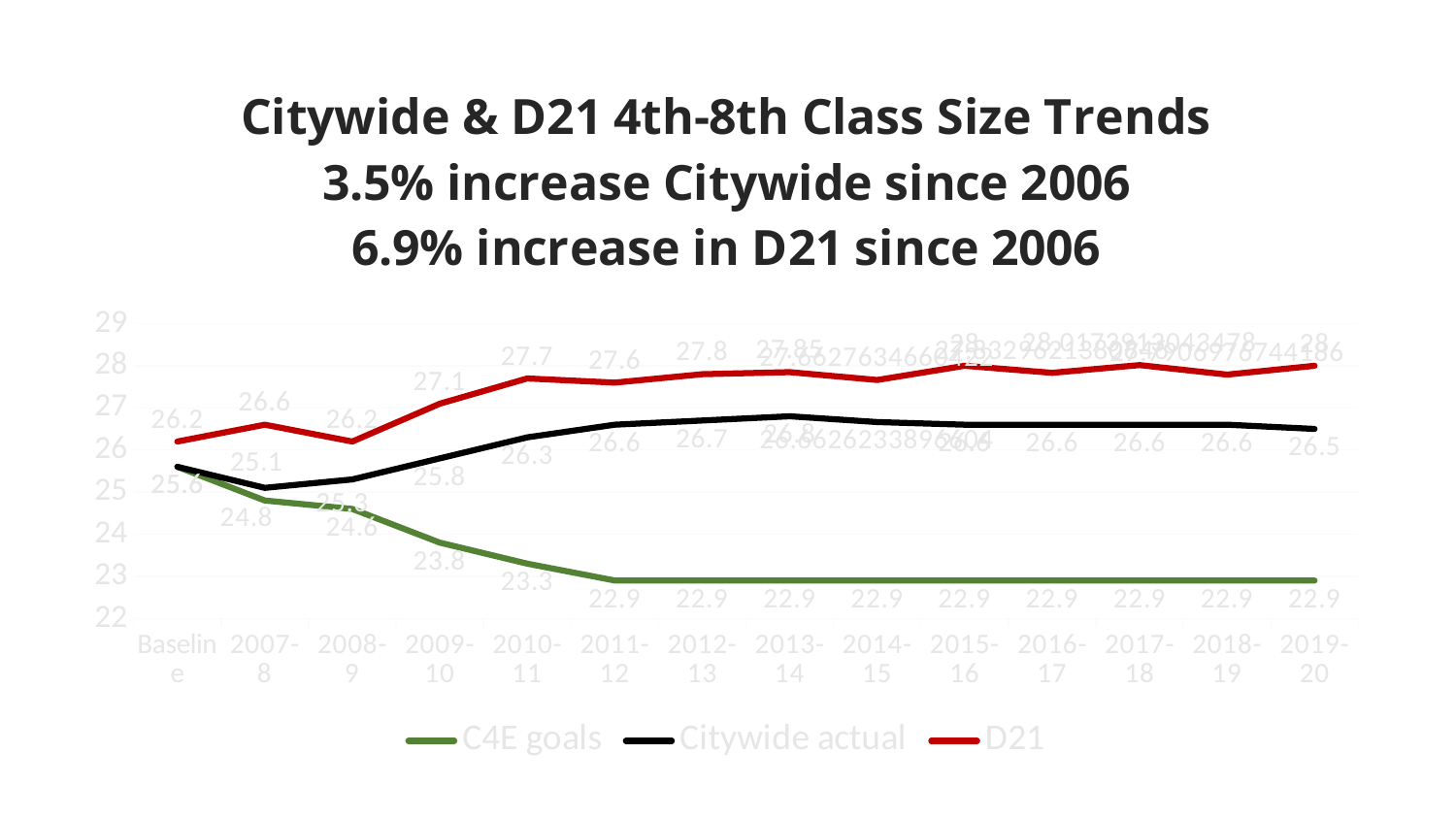
What is the difference between the D21 value and the Citywide actual value for 2010-11? 1.4 What is the C4E goals value for 2009-10? 23.8 What is the Citywide actual value for 2019-20? 26.5 How many categories are shown along the x axis? 14 What is the D21 value for 2010-11? 27.7 What is the Citywide actual value for 2007-8? 25.1 Which is larger for 2009-10, the D21 value or the Citywide actual value? D21 What colour is the D21 line in the legend? red How many series does the legend list? 3 Is the D21 value for 2015-16 greater or less than 27? greater Do the C4E goals values rise or fall from Baseline to 2011-12? fall What kind of chart is shown on the slide? line chart